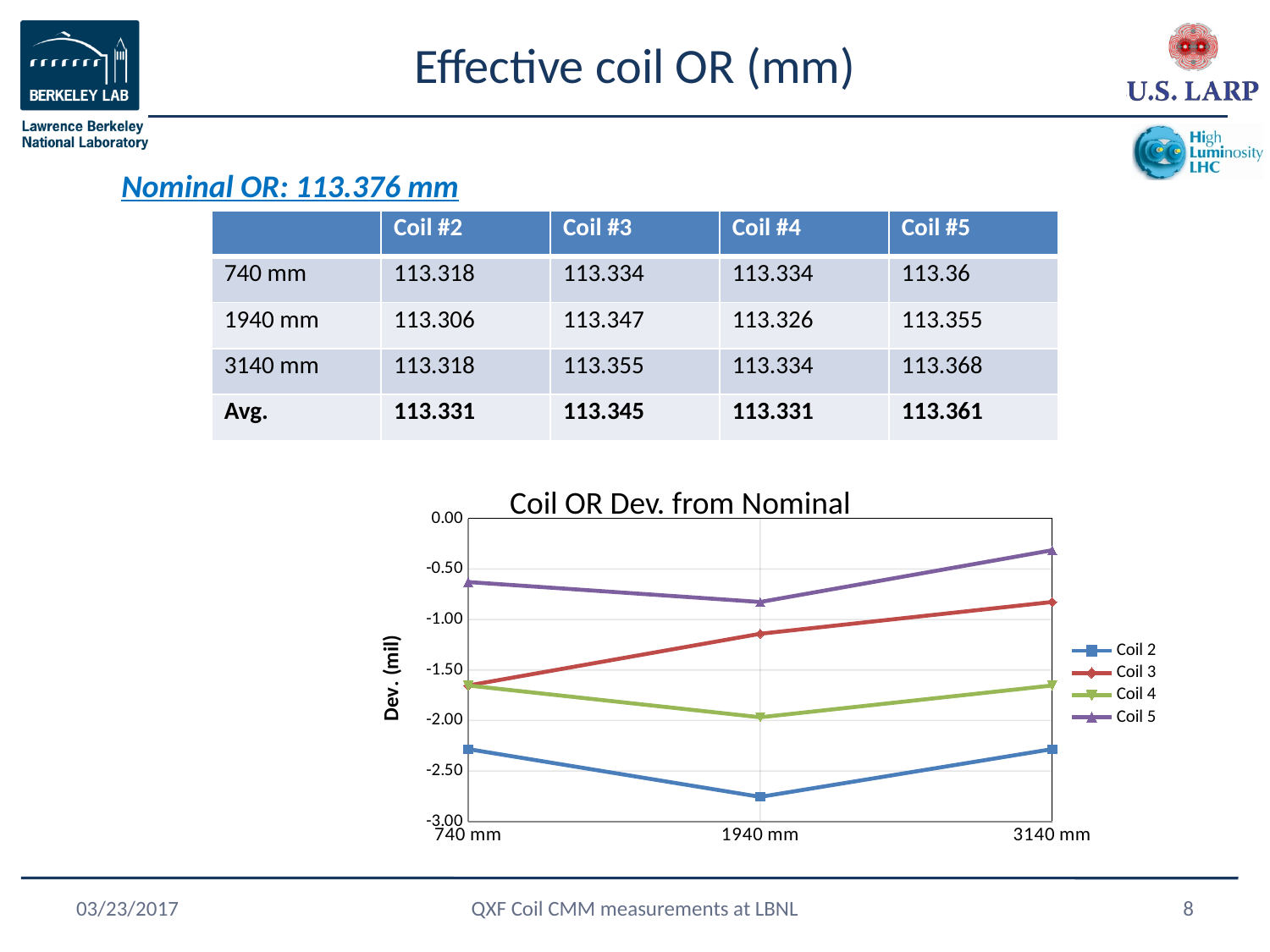
Is the value for Coil 3 at 1940 mm greater or less than -1.00? less Which series has the highest value at 3140 mm? Coil 5 How many series does the legend of the chart list? 4 Is the value for Coil 2 at 740 mm greater or less than -2.50? greater What kind of chart is shown on the slide? line chart Is the value for Coil 2 at 1940 mm greater or less than -2.50? less At 3140 mm, which is larger, the value for Coil 3 or the value for Coil 4? Coil 3 Which series has the lowest value at 740 mm? Coil 2 What is the label of the vertical axis of the chart? Dev. (mil) What is the title of the chart? Coil OR Dev. from Nominal How many positions along the x axis are plotted in the chart? 3